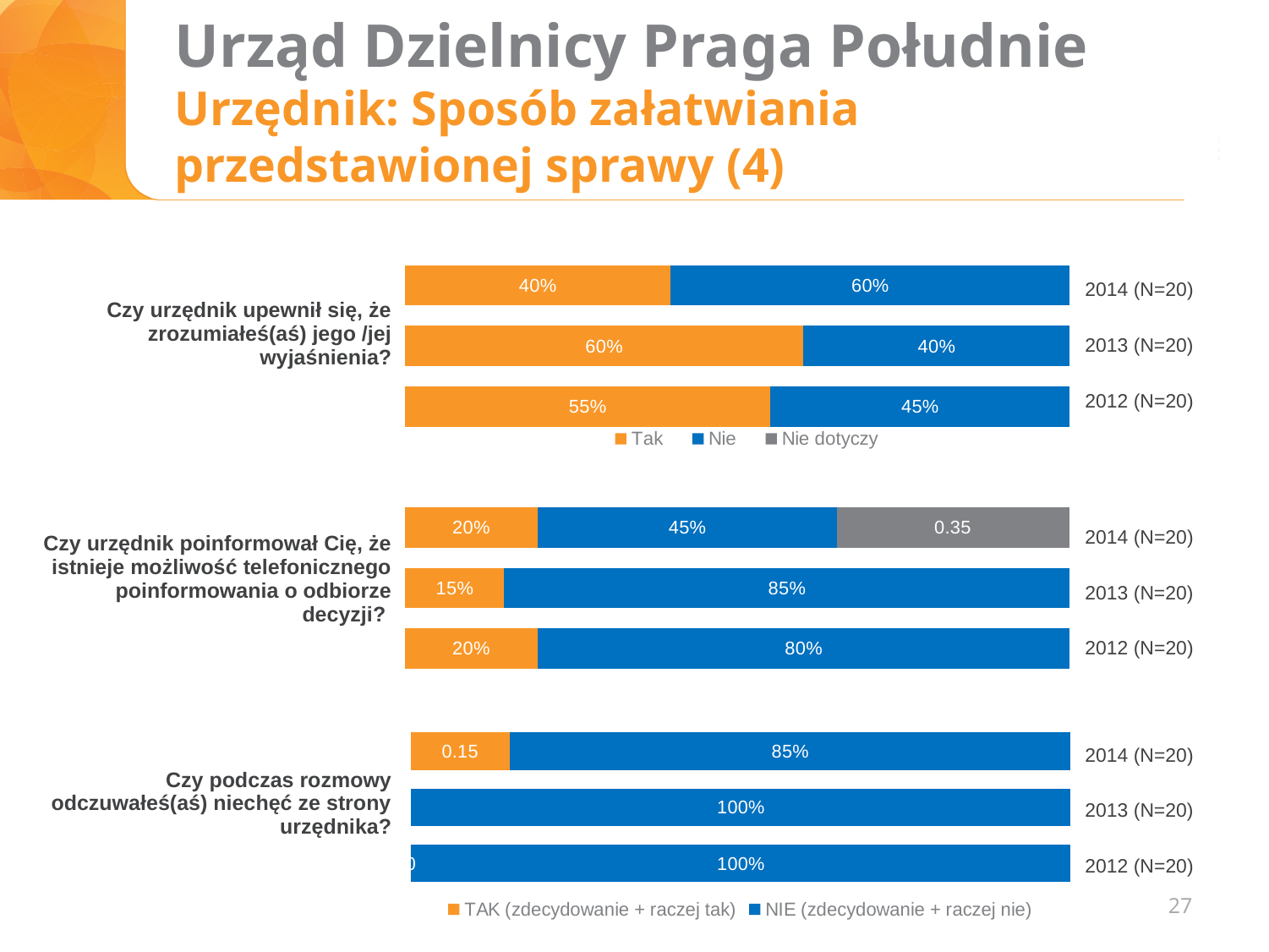
How many entries does the legend of the top chart list? 3 In the top chart, which year has the highest "Tak" value? 2013 (N=20) In the bottom chart, what is the value of the "TAK" segment for 2014 (N=20)? 0.15 What type of chart is used on this slide? Stacked bar chart In the top chart, what is the value of "Nie" for 2012 (N=20)? 45% In the top chart, what is the difference between the "Tak" values for 2013 and 2014? 20% In the middle chart ("Czy urzędnik poinformował Cię, że istnieje możliwość telefonicznego poinformowania o odbiorze decyzji?"), what is the value of "Nie" for 2013 (N=20)? 85% In the top chart ("Czy urzędnik upewnił się, że zrozumiałeś(aś) jego /jej wyjaśnienia?"), what is the value of "Tak" for 2014 (N=20)? 40% In the middle chart, which year has the lowest "Tak" value? 2013 (N=20) In the middle chart, is the "Nie" value for 2012 larger or smaller than the "Nie" value for 2014? larger In the middle chart, what is the value of the grey "Nie dotyczy" segment for 2014 (N=20)? 0.35 In the bottom chart ("Czy podczas rozmowy odczuwałeś(aś) niechęć ze strony urzędnika?"), what is the value of "NIE" for 2013 (N=20)? 100%